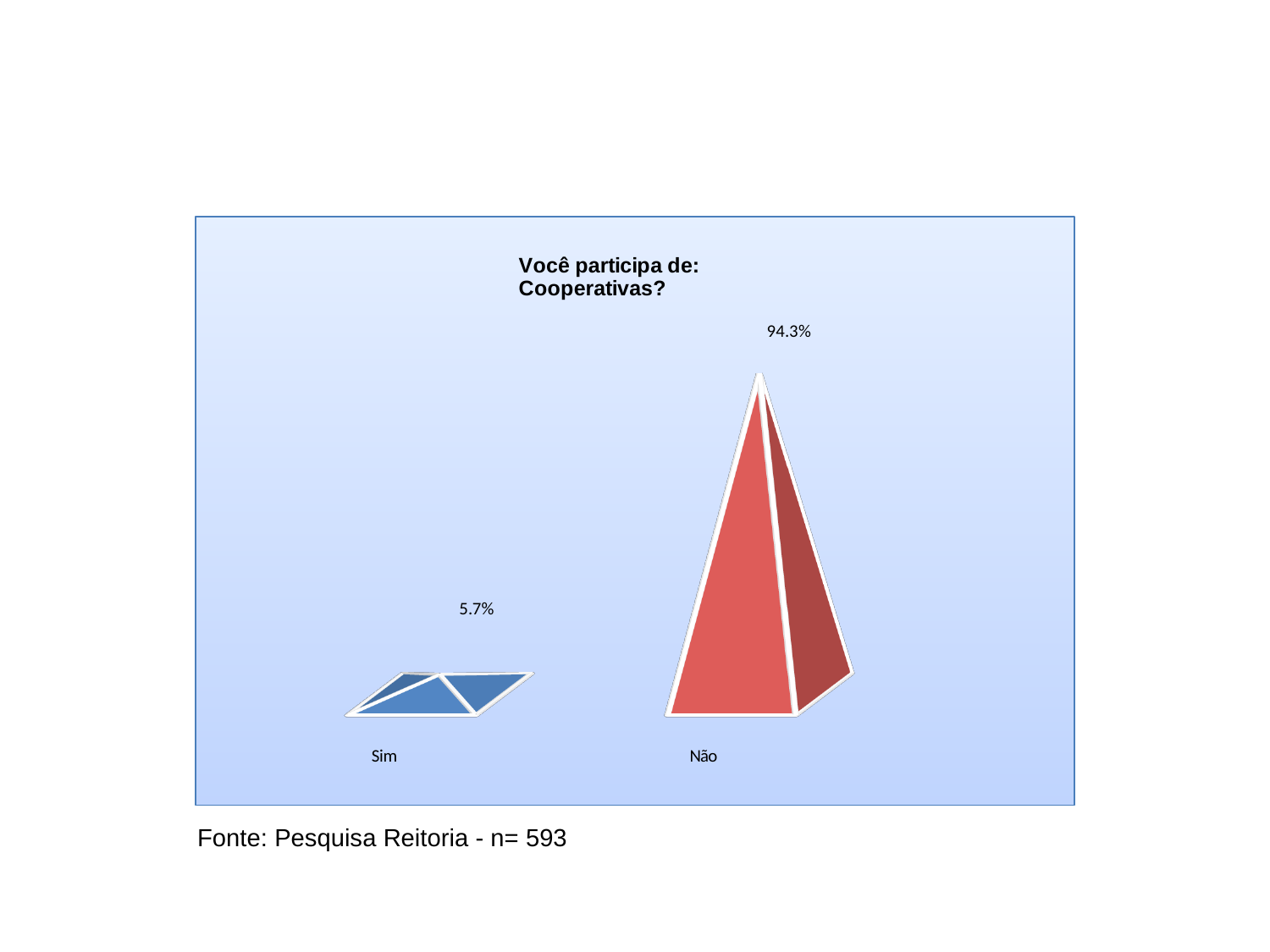
What colour is the bar for Não? Red Which category has the lowest value? Sim What is the difference between the values for Não and Sim? 88.6% What is the title of the chart? Você participa de: Cooperativas? Which is larger, the value for Sim or the value for Não? Não How many categories are shown in the chart? 2 What kind of chart is shown on the slide? Bar chart What is the value for Sim? 5.7% What is the total of the values for Sim and Não? 100% What is the value for Não? 94.3% Which category has the highest value? Não